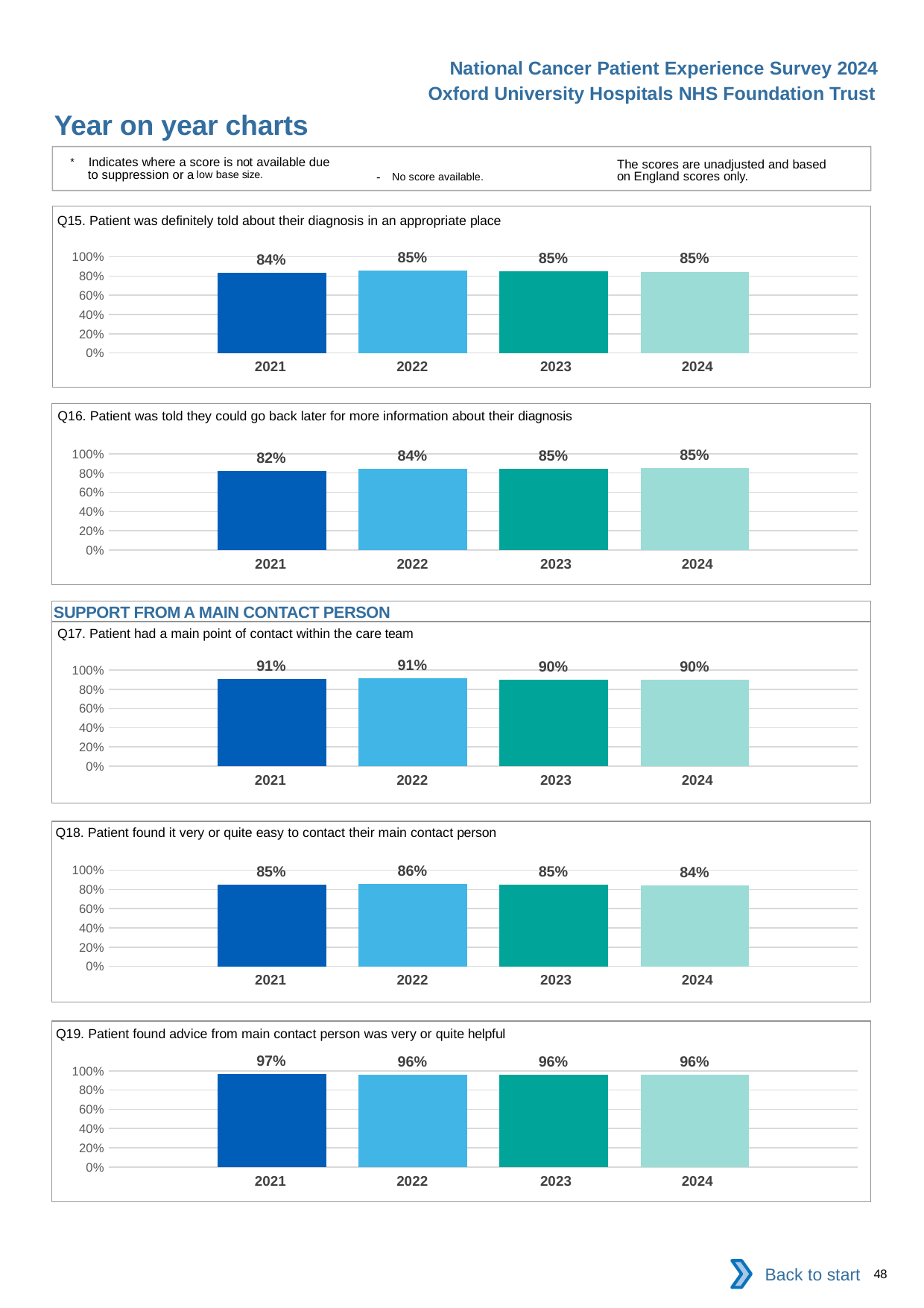
In the Q16 chart, what is the value for 2022? 84% In the Q19 chart, what is the value for 2023? 96% In the Q17 chart, what is the difference between the 2021 value and the 2024 value? 1% In the Q16 chart, which year has the lowest value? 2021 In the Q18 chart, is the value for 2023 greater or less than 60%? greater What kind of chart is the Q17 chart? bar chart How many years are shown in the Q15 chart? 4 In the Q16 chart, is the value for 2021 larger or smaller than the value for 2024? smaller In the Q18 chart, what is the value for 2024? 84% In the Q18 chart, which year has the highest value? 2022 In the Q15 chart, what is the value for 2021? 84% In the Q19 chart, which year has the highest value? 2021